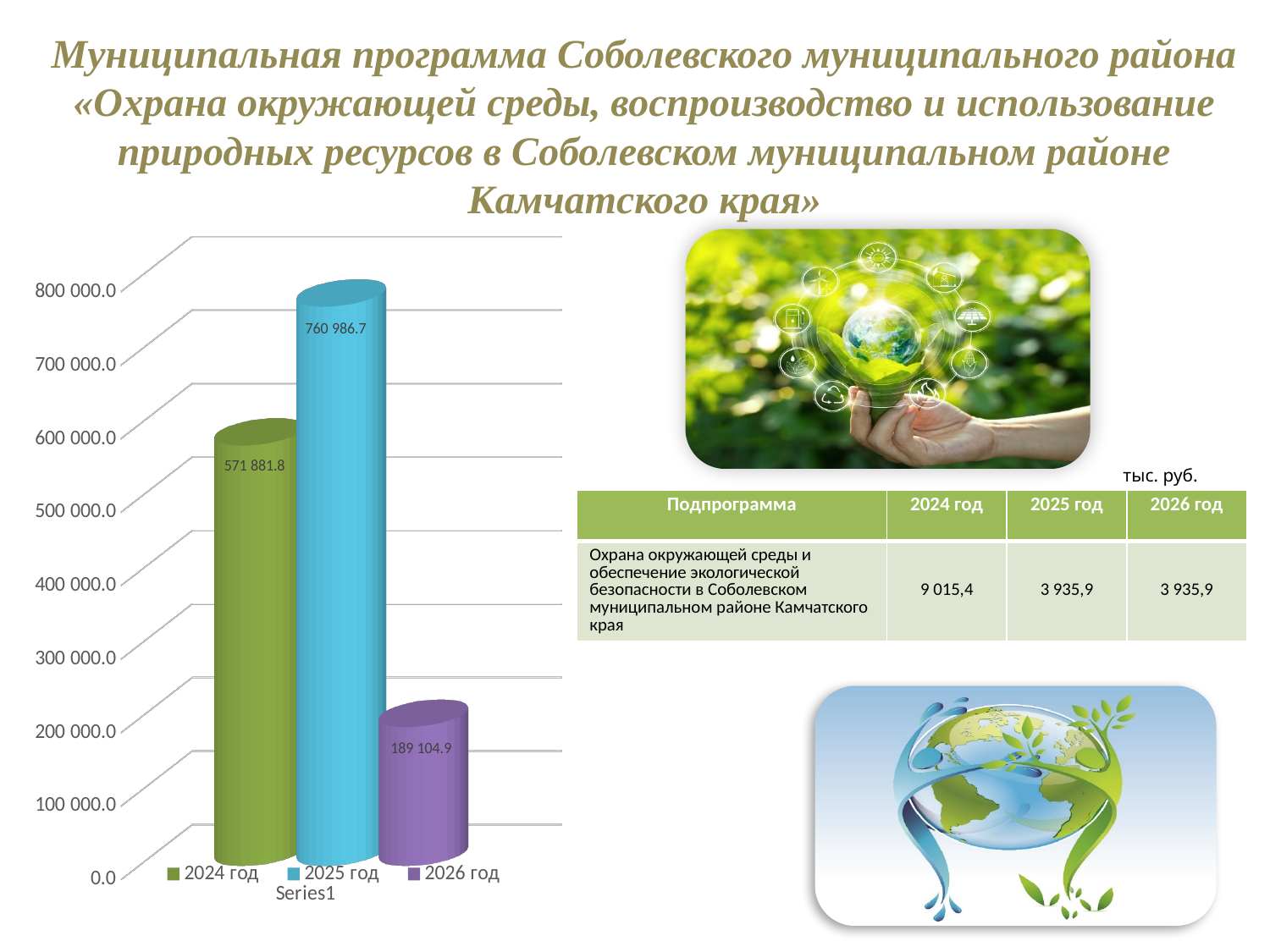
What is the difference between the 2025 год and 2024 год values in the bar chart? 189 104.9 What colour is the bar for the 2025 год series in the chart? blue Is the value for 2025 год in the bar chart greater or less than 700 000.0? greater Which series has the highest value in the bar chart? 2025 год What is the value shown for the 2024 год series in the bar chart? 571 881.8 What is the difference between the 2024 год and 2026 год values in the bar chart? 382 776.9 What is the value shown for the 2025 год series in the bar chart? 760 986.7 How many series does the legend of the bar chart list? 3 What is the value shown for the 2026 год series in the bar chart? 189 104.9 Which is larger in the bar chart, the value for 2024 год or the value for 2026 год? 2024 год Which series has the lowest value in the bar chart? 2026 год What kind of chart is shown on the left of the slide? bar chart